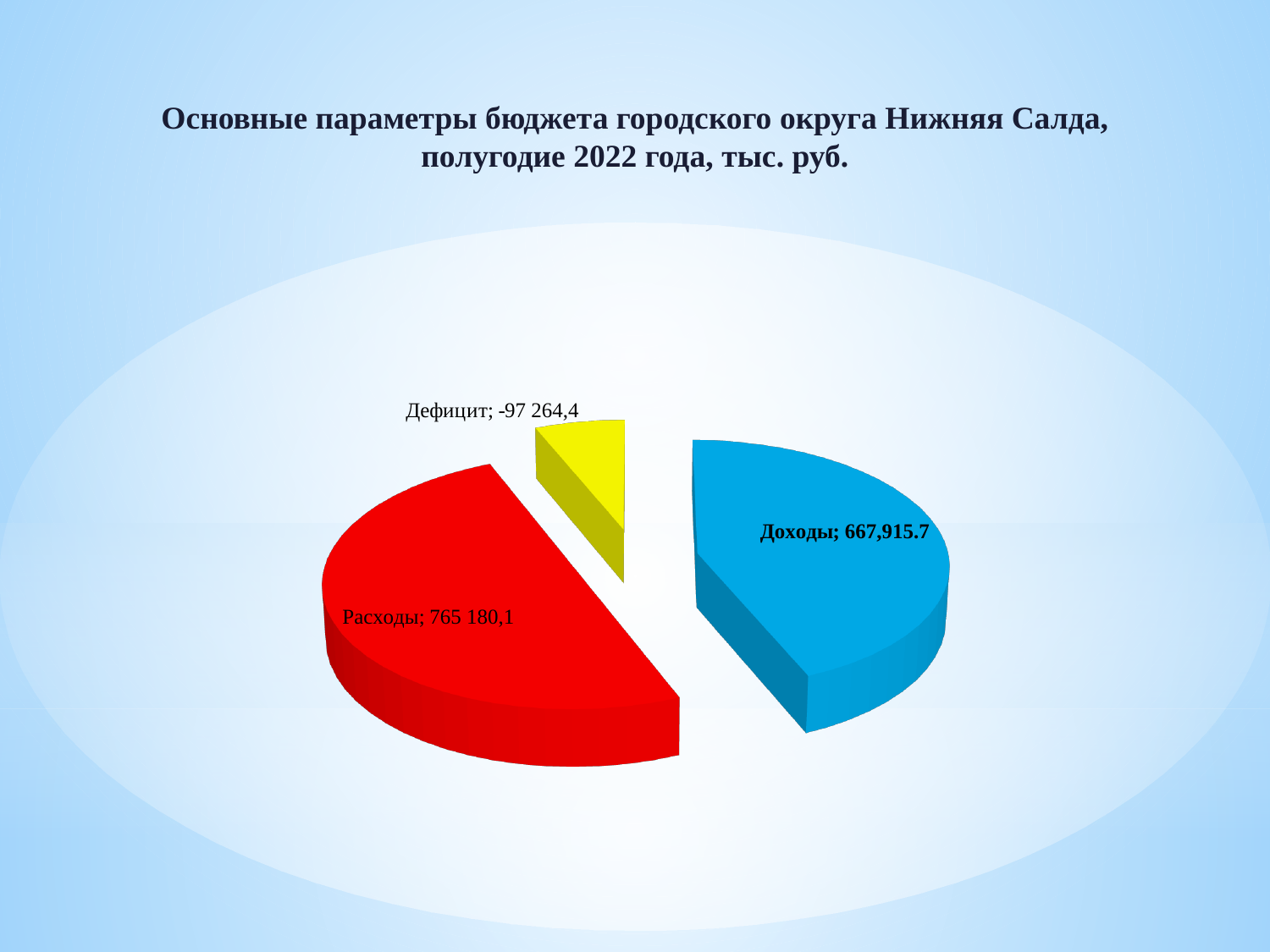
What is the difference between Расходы and Доходы? 97 264,4 What is the value shown for Доходы? 667,915.7 Which is larger, Доходы or Расходы? Расходы What is the value shown for Расходы? 765 180,1 Which category has the largest slice in the pie chart? Расходы What is the value shown for Дефицит? -97 264,4 What is the title of the slide? Основные параметры бюджета городского округа Нижняя Салда, полугодие 2022 года, тыс. руб. Which category has the smallest slice in the pie chart? Дефицит What colour is the Доходы slice? Blue How many slices does the pie chart have? 3 What kind of chart is shown on the slide? Pie chart